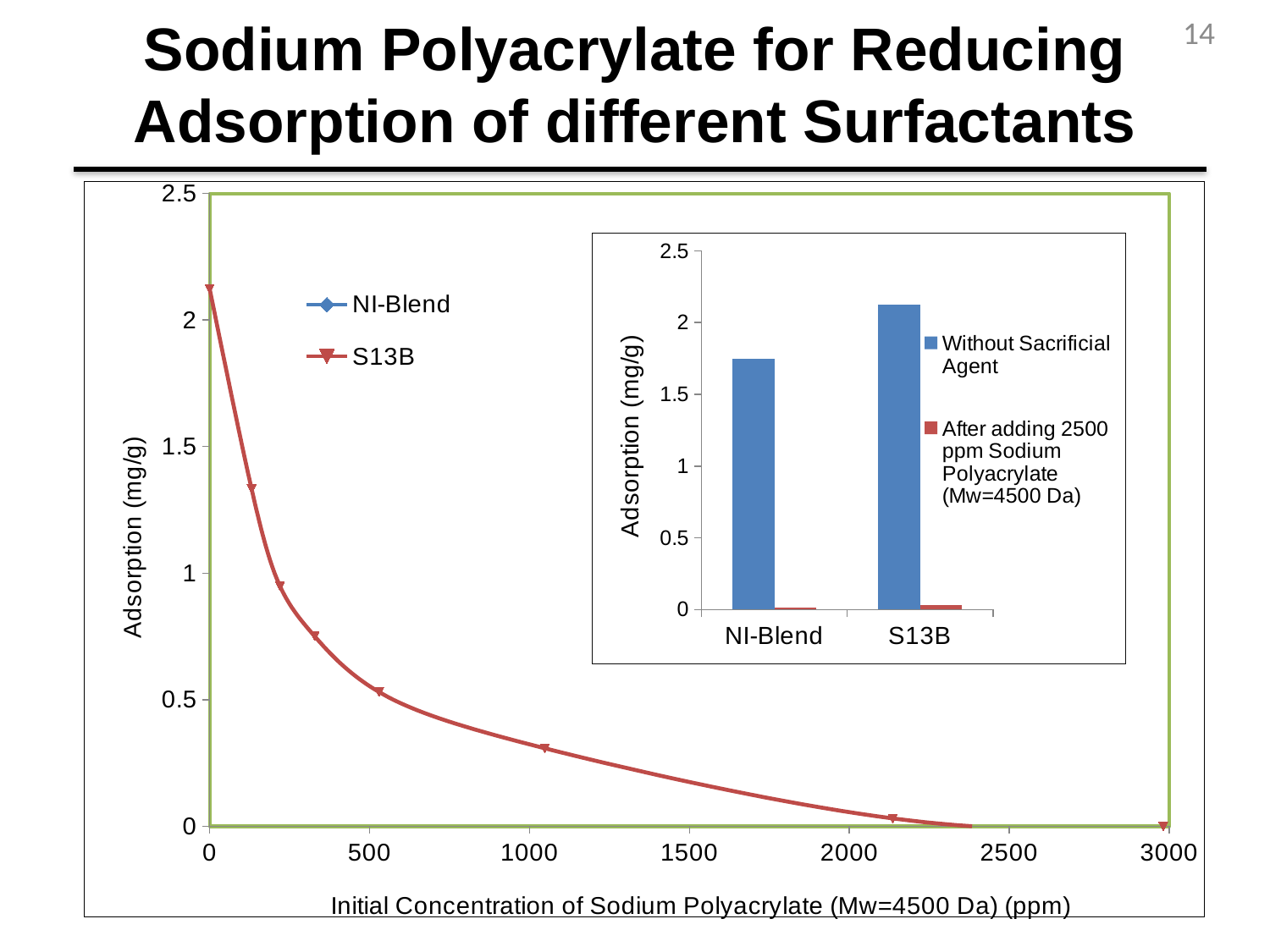
What kind of chart is the large chart on the slide? line chart In the inset bar chart, is the adsorption of S13B after adding 2500 ppm sodium polyacrylate greater or less than 0.5 mg/g? less In the large line chart, is the S13B adsorption at 0 ppm greater or less than 2 mg/g? greater In the large line chart, what is the label of the x axis? Initial Concentration of Sodium Polyacrylate (Mw=4500 Da) (ppm) In the large line chart, is the S13B adsorption at 1000 ppm greater or less than 0.5 mg/g? less In the large line chart, how many series does the legend list? 2 In the inset bar chart, how many categories are shown on the x axis? 2 In the inset bar chart, how many series does the legend list? 2 What kind of chart is the inset chart on the slide? bar chart In the inset bar chart, which surfactant has the higher adsorption without sacrificial agent? S13B In the large line chart, does the S13B adsorption rise or fall as the initial concentration of sodium polyacrylate increases? fall